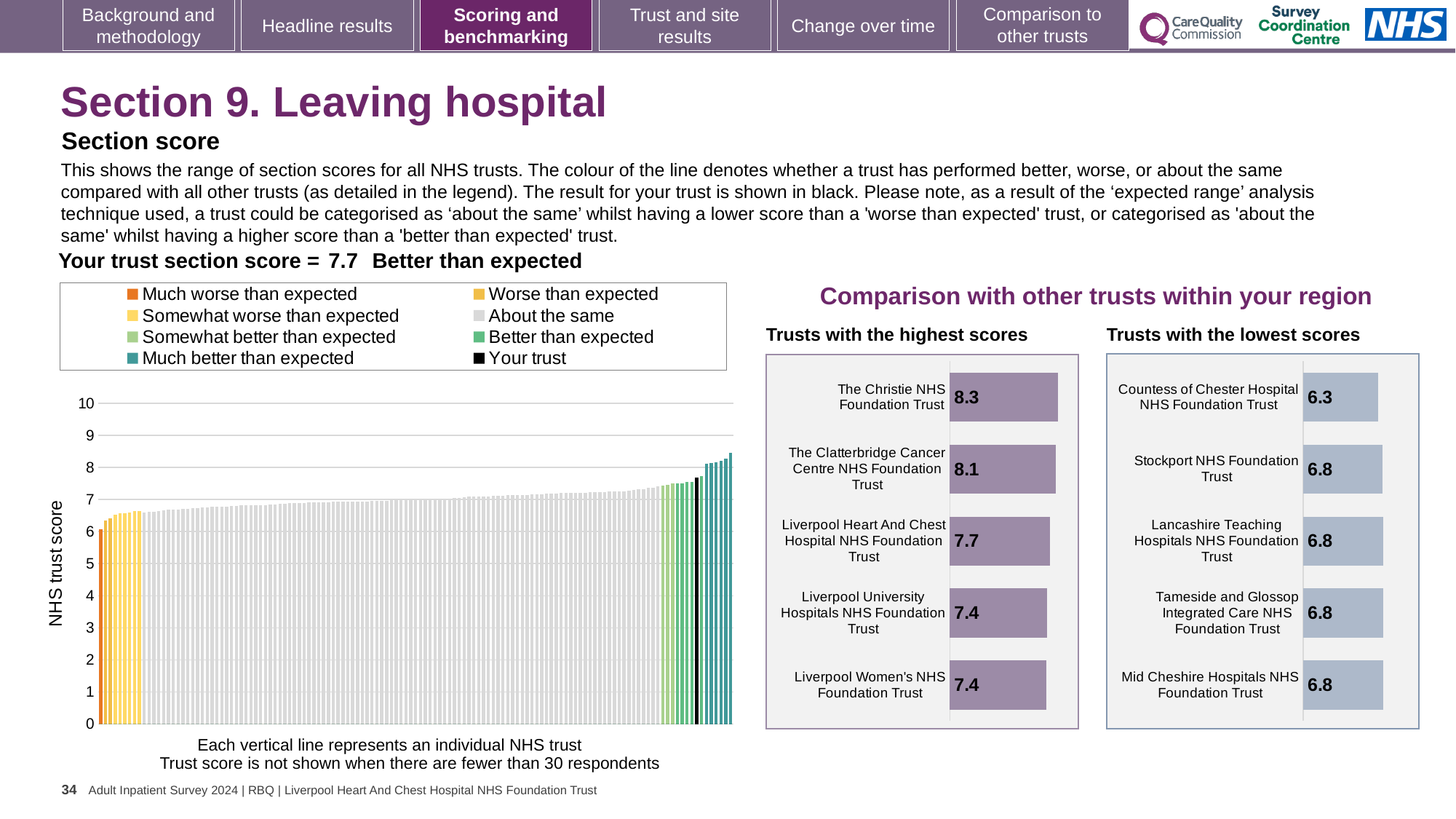
In the 'Trusts with the lowest scores' chart, which trust has the lowest score? Countess of Chester Hospital NHS Foundation Trust In the 'Trusts with the highest scores' chart, which has the larger score: The Clatterbridge Cancer Centre NHS Foundation Trust or Liverpool Heart And Chest Hospital NHS Foundation Trust? The Clatterbridge Cancer Centre NHS Foundation Trust What kind of chart is the large 'NHS trust score' chart on the left? Bar chart In the 'Trusts with the highest scores' chart, which trust has the highest score? The Christie NHS Foundation Trust In the 'Trusts with the highest scores' chart, what is the score for The Clatterbridge Cancer Centre NHS Foundation Trust? 8.1 In the 'Trusts with the lowest scores' chart, what is the score for Countess of Chester Hospital NHS Foundation Trust? 6.3 In the 'Trusts with the highest scores' chart, what is the difference between the scores of The Christie NHS Foundation Trust and Liverpool Women's NHS Foundation Trust? 0.9 In the 'Trusts with the lowest scores' chart, what is the difference between the scores of Stockport NHS Foundation Trust and Countess of Chester Hospital NHS Foundation Trust? 0.5 In the large 'NHS trust score' chart on the left, do the trust scores rise or fall from left to right? Rise In the 'Trusts with the highest scores' chart, how many trusts are shown? 5 In the large 'NHS trust score' chart on the left, how many entries does the legend list? 8 In the 'Trusts with the highest scores' chart, what is the score for The Christie NHS Foundation Trust? 8.3